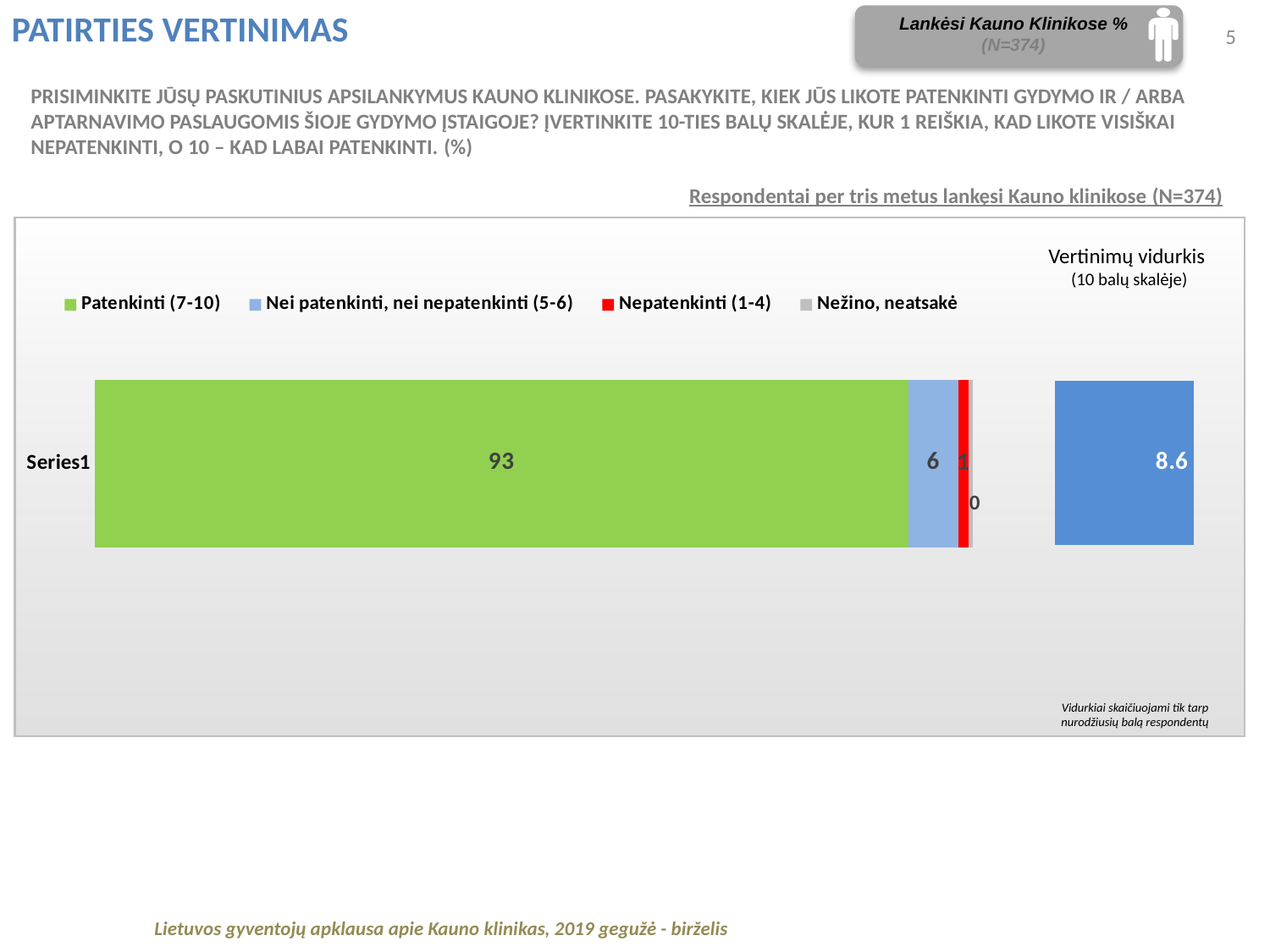
In the stacked bar chart on the left, which is larger: Nei patenkinti, nei nepatenkinti (5-6) or Nepatenkinti (1-4)? Nei patenkinti, nei nepatenkinti (5-6) In the stacked bar chart on the left, which series has the highest value? Patenkinti (7-10) In the chart on the right titled Vertinimų vidurkis, what is the average rating shown? 8.6 How many series does the legend of the stacked bar chart on the left list? 4 In the stacked bar chart on the left, what is the value for Patenkinti (7-10)? 93 In the stacked bar chart on the left, what is the difference between the values for Patenkinti (7-10) and Nei patenkinti, nei nepatenkinti (5-6)? 87 In the stacked bar chart on the left, what is the value for Nepatenkinti (1-4)? 1 What kind of chart is the chart on the left? Stacked bar chart In the stacked bar chart on the left, which series has the lowest value? Nežino, neatsakė In the stacked bar chart on the left, what is the value for Nežino, neatsakė? 0 In the stacked bar chart on the left, what is the value for Nei patenkinti, nei nepatenkinti (5-6)? 6 In the stacked bar chart on the left, what is the total of the stacked bar for Series1? 100